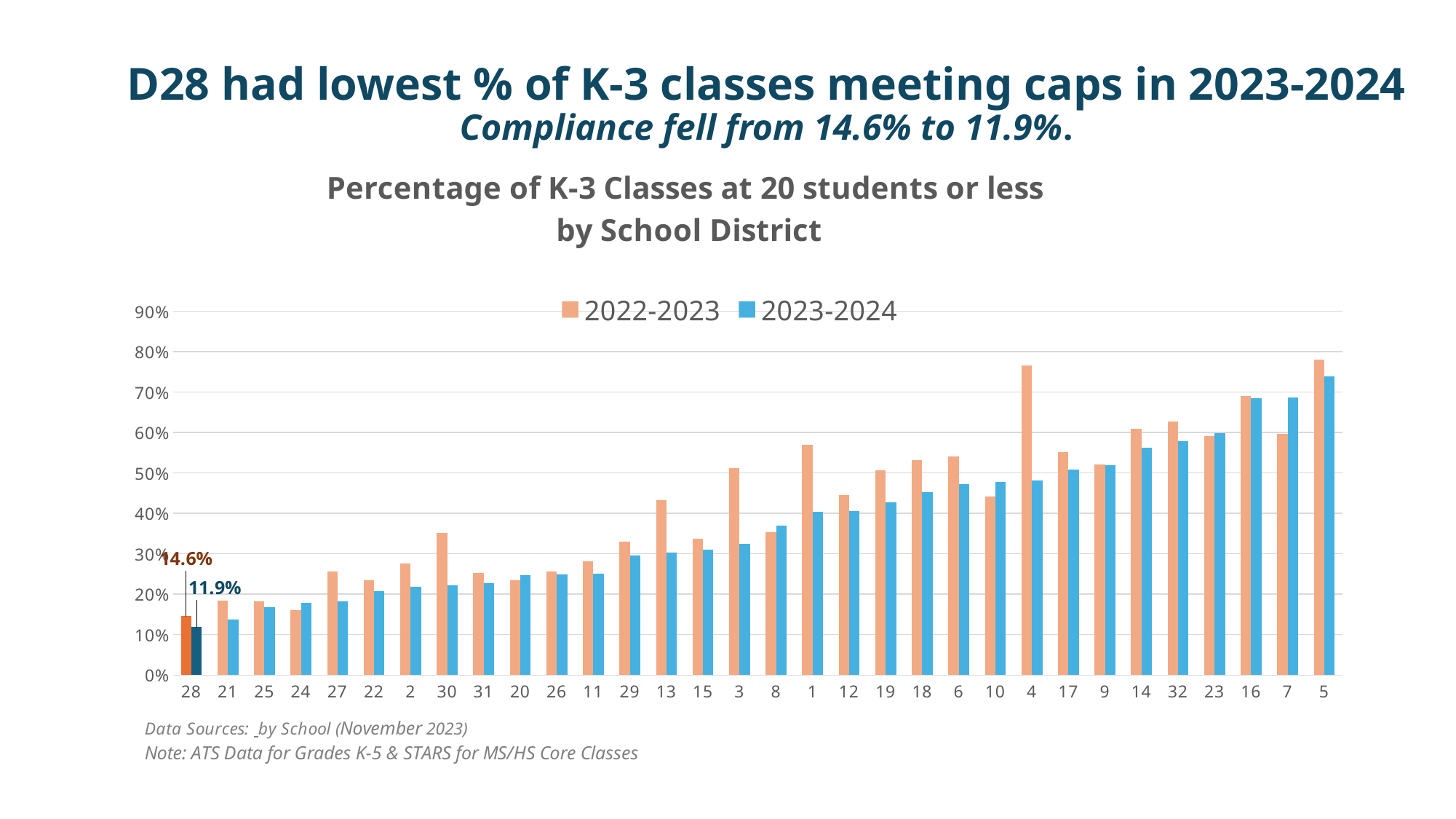
What kind of chart is used to show the percentage of K-3 classes by school district? Bar chart What was the percentage of K-3 classes at 20 students or less in District 28 in 2023-2024? 11.9% Is the 2022-2023 value for District 30 greater or less than 30%? greater How many school districts are shown on the x axis of the chart? 32 How many series does the chart's legend list? 2 For District 4, which series has the larger value, 2022-2023 or 2023-2024? 2022-2023 What was the percentage of K-3 classes at 20 students or less in District 28 in 2022-2023? 14.6% Do the values generally rise or fall moving from left to right along the x axis? Rise Is the 2022-2023 value for District 4 greater or less than 70%? greater By how many percentage points did District 28's value fall from 2022-2023 to 2023-2024? 2.7 percentage points Which district has the highest 2023-2024 value? 5 Which district has the lowest 2023-2024 value? 28